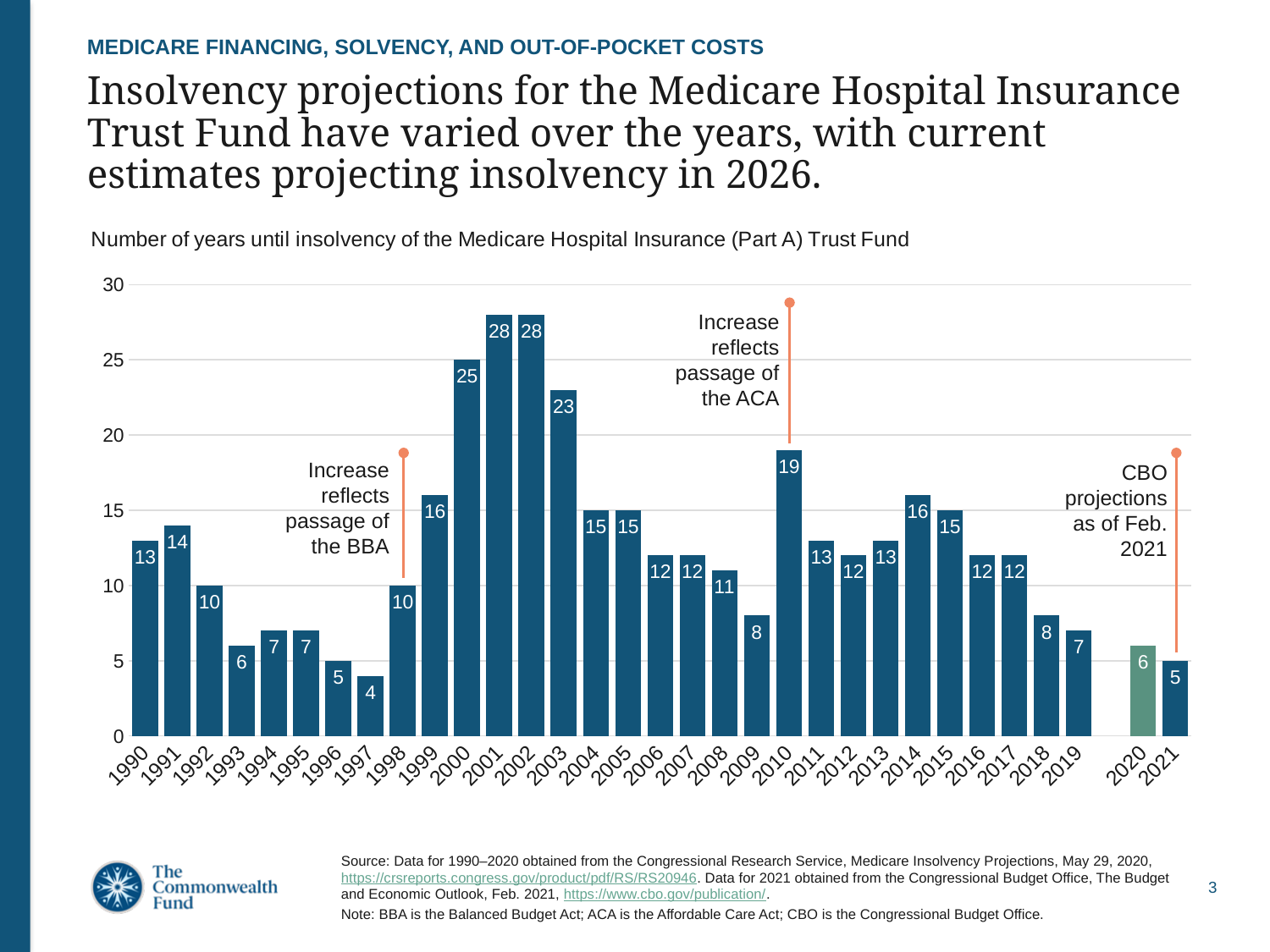
Which year has the lowest number of years until insolvency? 1997 What is the highest value shown on the chart? 28 What kind of chart is shown on the slide? Bar chart Is the value for 2001 greater or less than 25? greater What value is shown for 2021 (the CBO projection)? 5 Do the values rise or fall from 2014 to 2019? Fall How many years (bars) are shown on the chart? 32 Which year has a larger value, 1999 or 2014? They are equal (16) What is the difference between the values for 2000 and 2003? 2 What is the number of years until insolvency shown for 2010? 19 What is the number of years until insolvency shown for 1997? 4 Which year has a larger value, 2010 or 2011? 2010